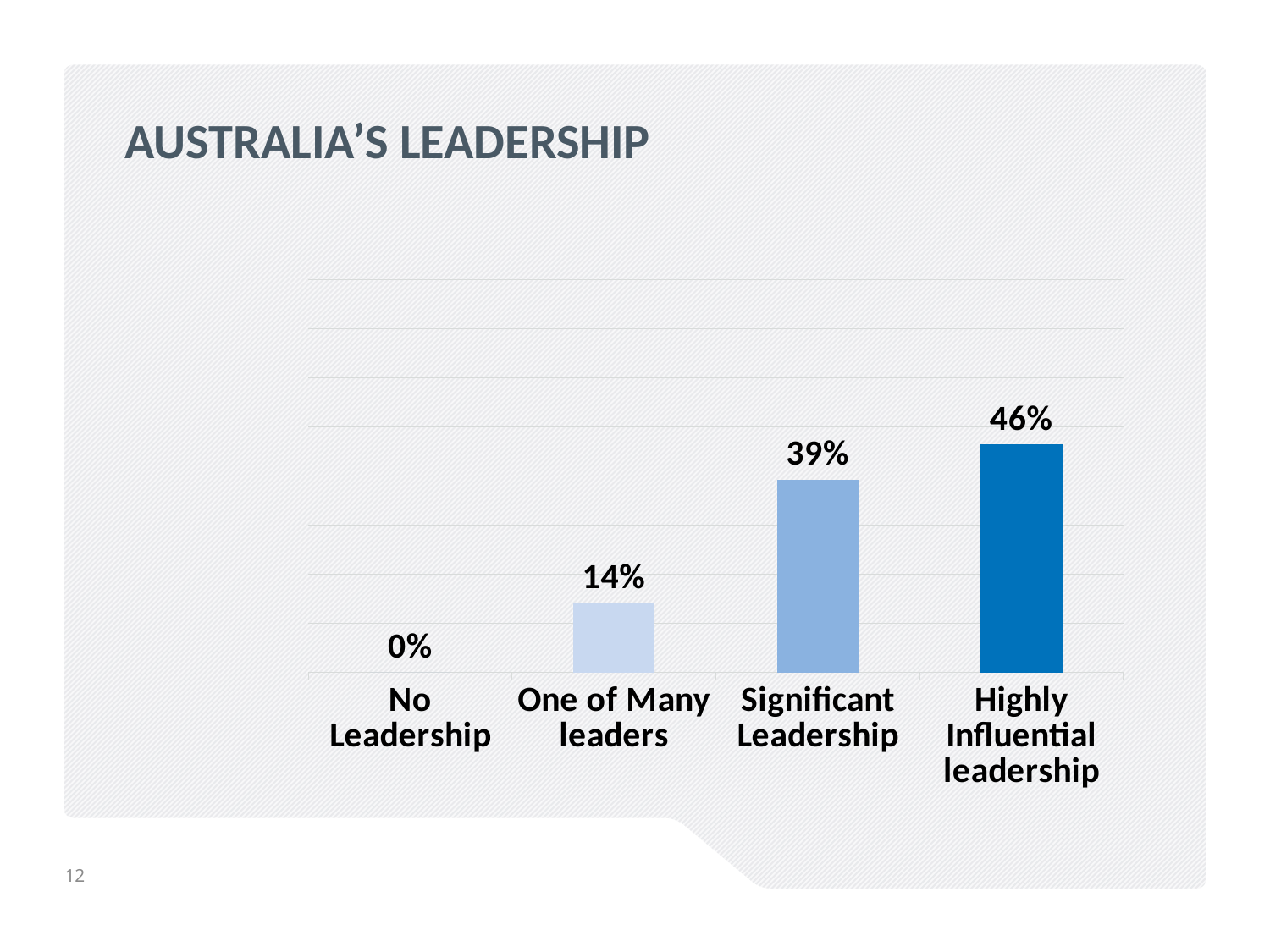
How many categories are shown on the x axis? 4 What is the value for Significant Leadership? 39% What kind of chart is shown on the slide? Bar chart What is the value for One of Many leaders? 14% Which category has the highest value? Highly Influential leadership What is the value for No Leadership? 0% Which category has the lowest value? No Leadership Do the values rise or fall from left to right along the x axis? Rise What is the difference between the values for Significant Leadership and One of Many leaders? 25% What is the value for Highly Influential leadership? 46% What is the difference between the values for Highly Influential leadership and Significant Leadership? 7% Which is larger, the value for One of Many leaders or the value for Significant Leadership? Significant Leadership